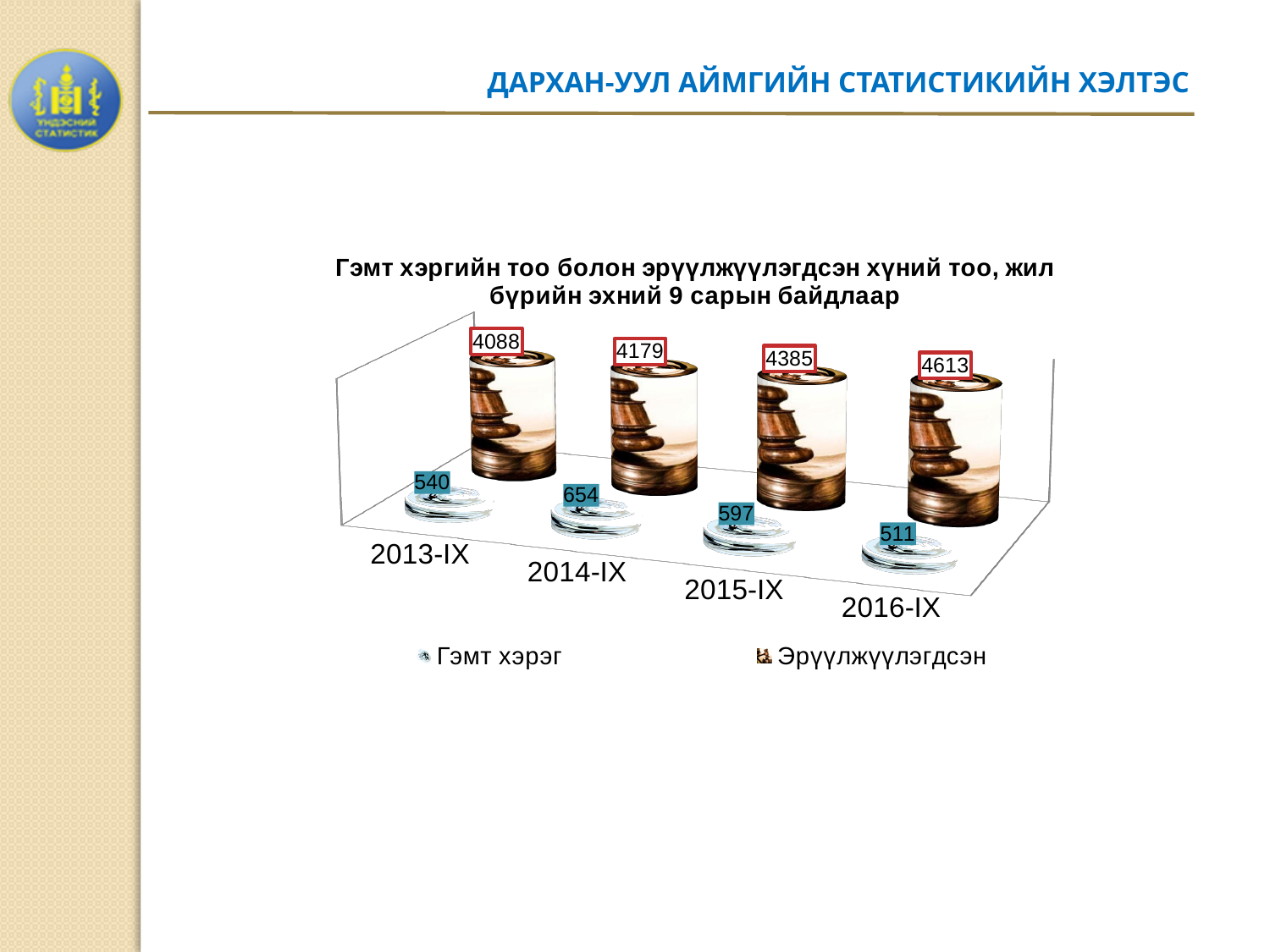
In which period is the Гэмт хэрэг value highest? 2014-IX In which period is the Эрүүлжүүлэгдсэн value highest? 2016-IX How many series does the legend list? 2 What is the value for Гэмт хэрэг in 2013-IX? 540 Does the Эрүүлжүүлэгдсэн series rise or fall from 2013-IX to 2016-IX? rise What is the value for Эрүүлжүүлэгдсэн in 2016-IX? 4613 In which period is the Гэмт хэрэг value lowest? 2016-IX What is the value for Гэмт хэрэг in 2014-IX? 654 How many periods are shown on the x axis? 4 What is the difference between the Эрүүлжүүлэгдсэн values for 2016-IX and 2013-IX? 525 Which is larger: the Гэмт хэрэг value for 2015-IX or for 2016-IX? 2015-IX What is the value for Эрүүлжүүлэгдсэн in 2015-IX? 4385